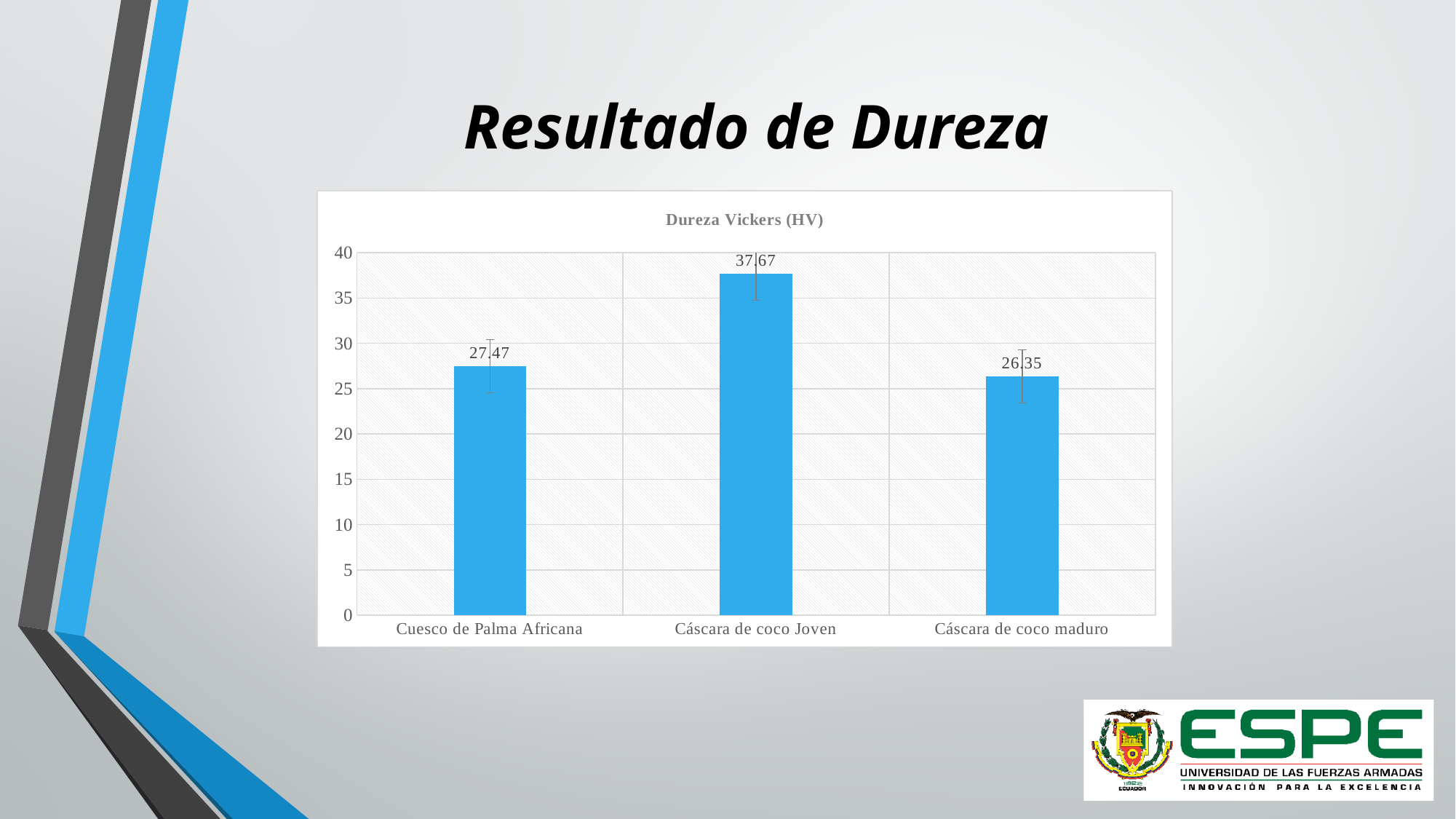
What kind of chart is shown on the slide? bar chart What is the Dureza Vickers (HV) value for Cuesco de Palma Africana? 27.47 Which has a larger Dureza Vickers value, Cáscara de coco Joven or Cáscara de coco maduro? Cáscara de coco Joven What is the title of the chart? Dureza Vickers (HV) How many categories are shown on the chart? 3 Which category has the highest Dureza Vickers (HV) value? Cáscara de coco Joven Which category has the lowest Dureza Vickers (HV) value? Cáscara de coco maduro Is the Dureza Vickers value for Cáscara de coco Joven greater or less than 35? greater What is the Dureza Vickers (HV) value for Cáscara de coco Joven? 37.67 What is the difference between the Dureza Vickers values for Cáscara de coco Joven and Cuesco de Palma Africana? 10.20 What is the difference between the Dureza Vickers values for Cuesco de Palma Africana and Cáscara de coco maduro? 1.12 What is the Dureza Vickers (HV) value for Cáscara de coco maduro? 26.35